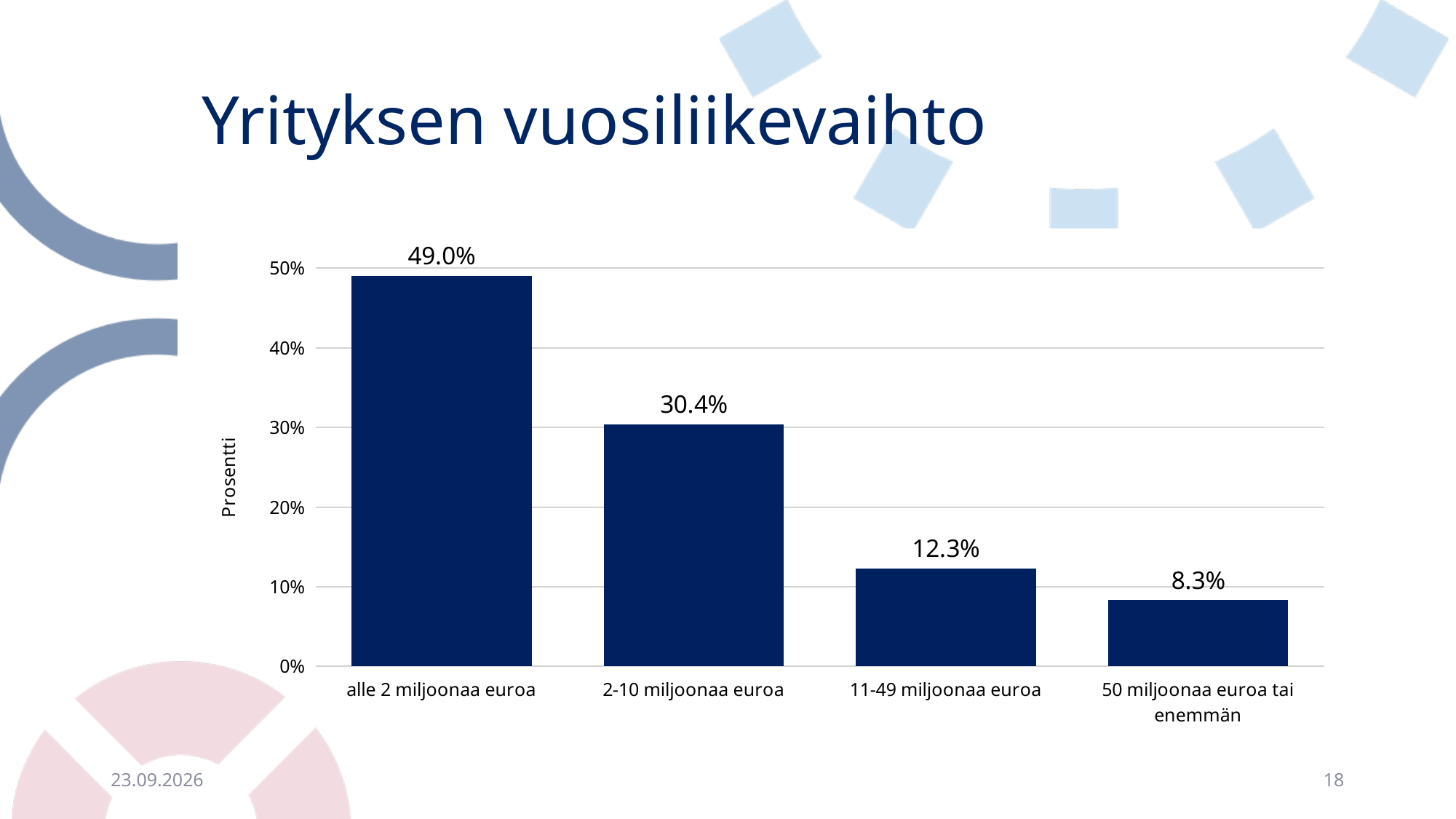
Do the values rise or fall from left to right along the x axis? fall What is the value for 'alle 2 miljoonaa euroa'? 49.0% What is the label of the vertical axis? Prosentti Which category has the lowest value? 50 miljoonaa euroa tai enemmän Which is larger, the value for '11-49 miljoonaa euroa' or '50 miljoonaa euroa tai enemmän'? 11-49 miljoonaa euroa Which category has the highest value? alle 2 miljoonaa euroa What kind of chart is shown on the slide? bar chart How many categories are shown in the chart? 4 What is the difference between the values for 'alle 2 miljoonaa euroa' and '2-10 miljoonaa euroa'? 18.6% What is the value for '11-49 miljoonaa euroa'? 12.3% What is the value for '50 miljoonaa euroa tai enemmän'? 8.3% What is the value for '2-10 miljoonaa euroa'? 30.4%